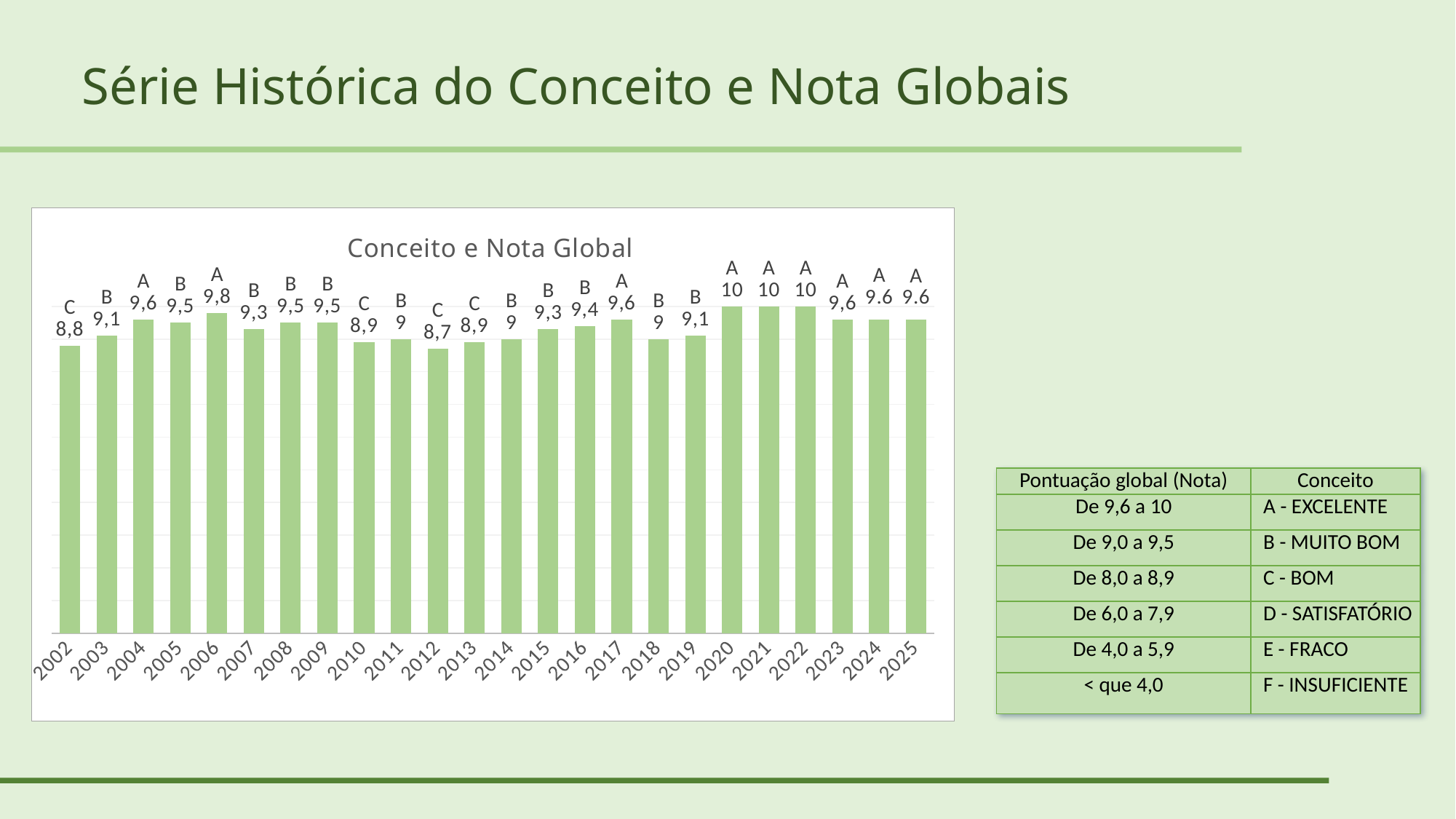
What is the highest nota global value shown in the chart? 10 What is the difference between the nota global for 2020 and for 2012? 1,3 Which year has the lowest nota global value? 2012 How many years are shown on the x axis of the chart? 24 Which year has a higher nota global, 2006 or 2007? 2006 What is the nota global value for 2002? 8,8 Do the nota global values rise or fall from 2012 to 2017? rise What type of chart is shown on the slide? bar chart What conceito letter is shown for 2012? C What is the title of the chart? Conceito e Nota Global What is the nota global value for 2016? 9,4 What is the nota global value for 2006? 9,8